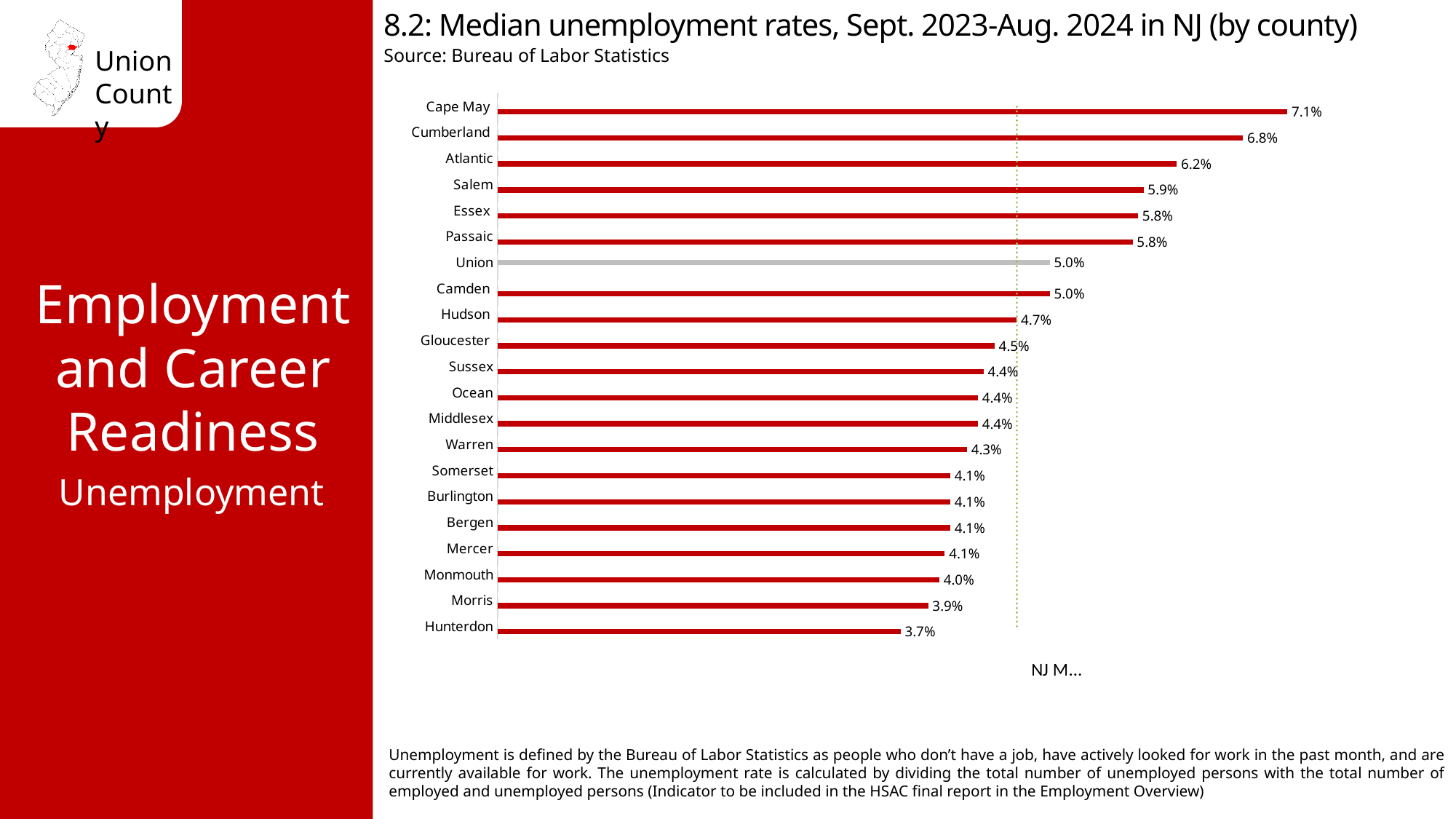
Which county's bar is shown in grey rather than red? Union How many counties are shown in the chart? 21 What is the difference between the median unemployment rates of Cape May and Hunterdon? 3.4% Which county has the lowest median unemployment rate? Hunterdon What is the difference between the median unemployment rates of Cumberland and Union? 1.8% Which county has a higher median unemployment rate, Atlantic or Hudson? Atlantic What is the median unemployment rate for Cape May? 7.1% What is the median unemployment rate for Union county? 5.0% What is the median unemployment rate for Morris? 3.9% What kind of chart is shown on the slide? Bar chart Which county has the highest median unemployment rate? Cape May What is the median unemployment rate for Hunterdon? 3.7%